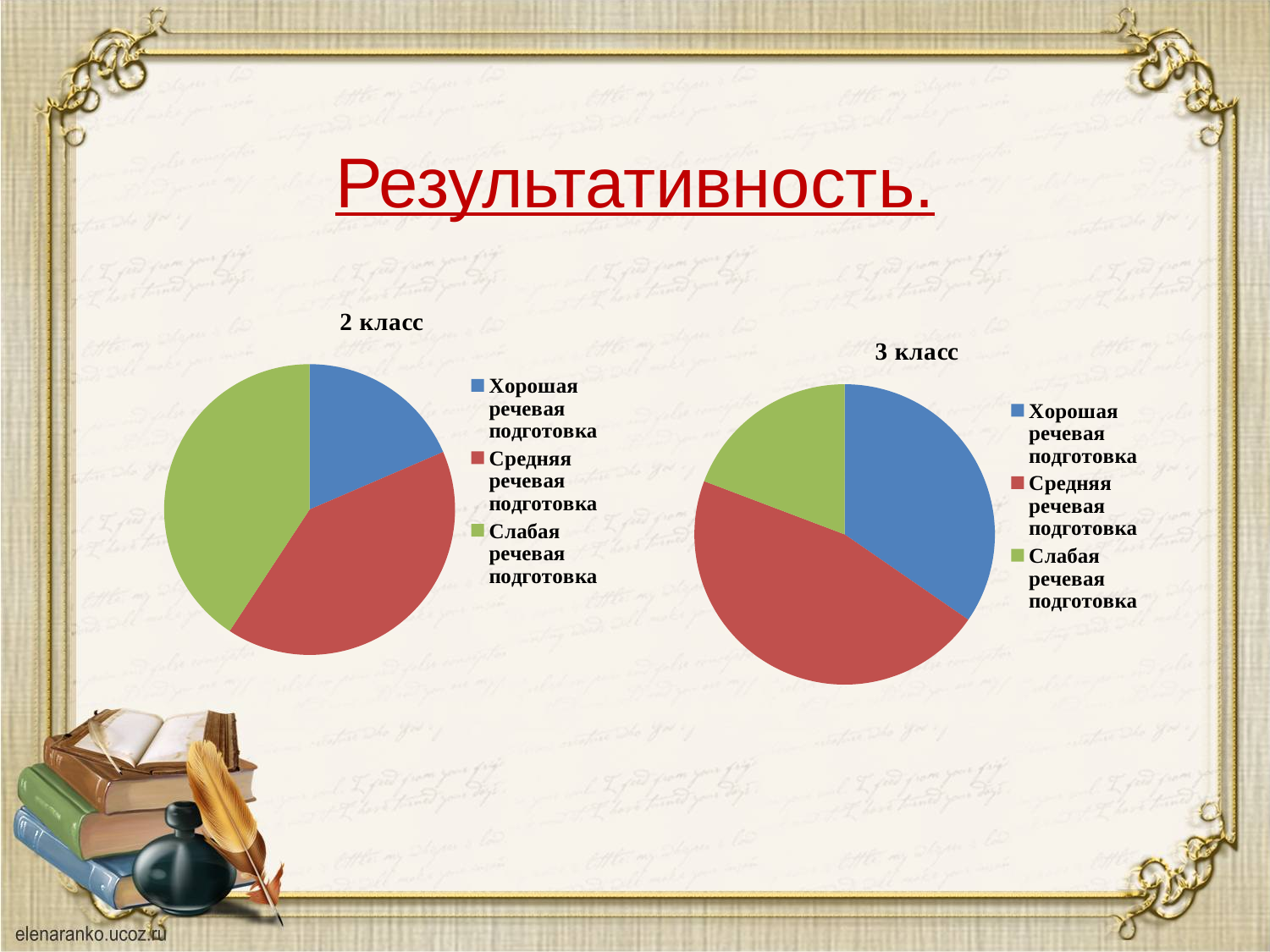
In the "3 класс" chart, which slice is larger: "Хорошая речевая подготовка" or "Средняя речевая подготовка"? Средняя речевая подготовка In the "3 класс" chart, which category has the largest slice? Средняя речевая подготовка What kind of chart is the "3 класс" chart? pie chart What is the title of the slide containing the two pie charts? Результативность. How many entries does the legend of the "2 класс" chart list? 3 In the "3 класс" chart, which category has the smallest slice? Слабая речевая подготовка In the "3 класс" chart, what colour represents "Слабая речевая подготовка"? green How many slices does the "3 класс" pie chart have? 3 How many slices does the "2 класс" pie chart have? 3 In the "2 класс" chart, which category has the smallest slice? Хорошая речевая подготовка In the "2 класс" chart, which slice is larger: "Хорошая речевая подготовка" or "Слабая речевая подготовка"? Слабая речевая подготовка What kind of chart is the "2 класс" chart? pie chart